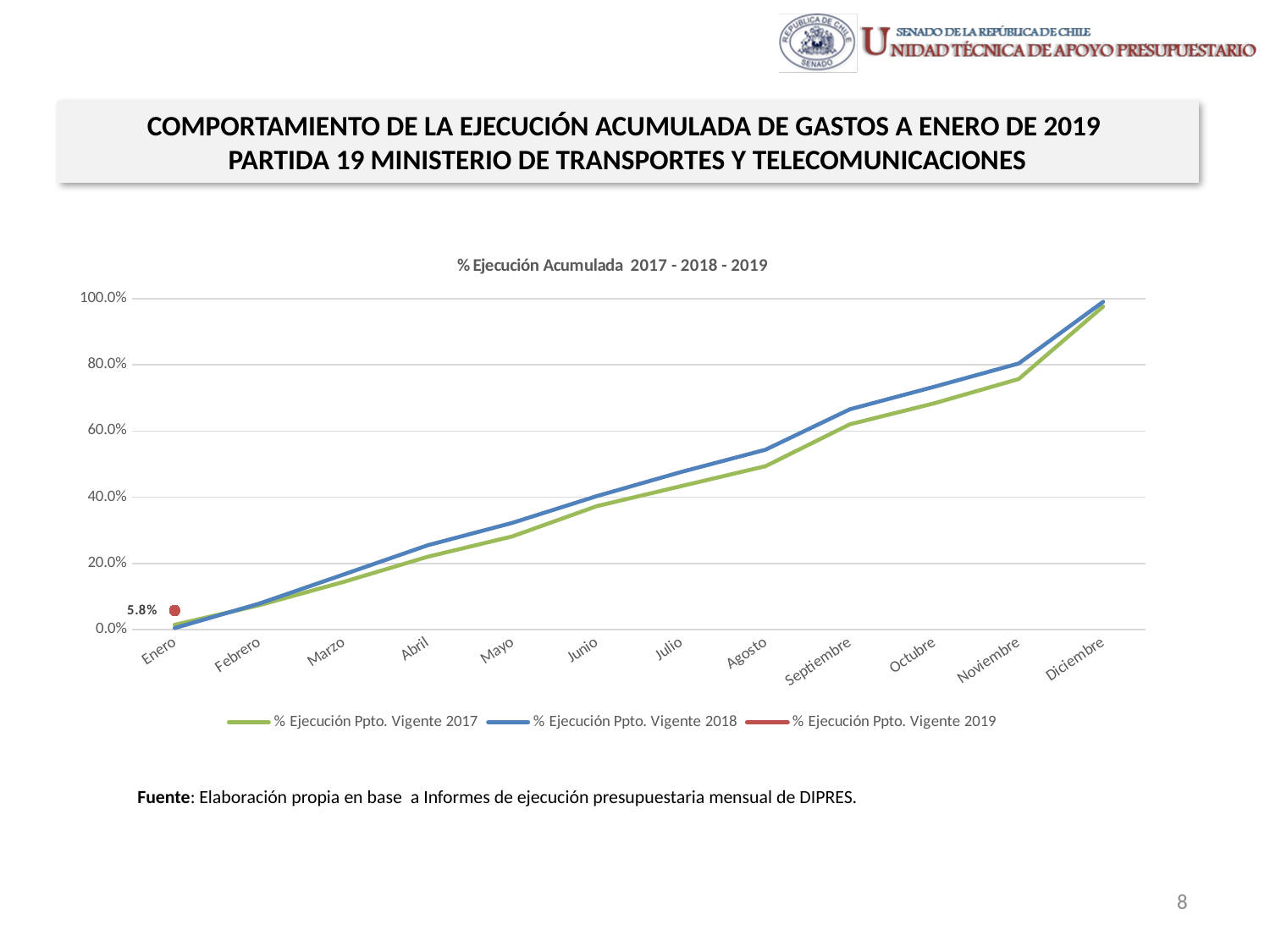
Is the value for % Ejecución Ppto. Vigente 2018 in Diciembre greater or less than 80.0%? greater Do the values for % Ejecución Ppto. Vigente 2018 rise or fall from Enero to Diciembre? rise Is the value for % Ejecución Ppto. Vigente 2018 in Septiembre greater or less than 60.0%? greater What kind of chart is shown on the slide? line chart In Noviembre, which series is higher: % Ejecución Ppto. Vigente 2017 or % Ejecución Ppto. Vigente 2018? % Ejecución Ppto. Vigente 2018 In which month does % Ejecución Ppto. Vigente 2018 reach its highest value? Diciembre Is the value for % Ejecución Ppto. Vigente 2017 in Marzo greater or less than 20.0%? less What is the value for % Ejecución Ppto. Vigente 2019 in Enero? 5.8% What is the title of the chart? % Ejecución Acumulada 2017 - 2018 - 2019 How many months are shown along the x axis? 12 How many series does the legend list? 3 In which month is % Ejecución Ppto. Vigente 2017 at its lowest value? Enero